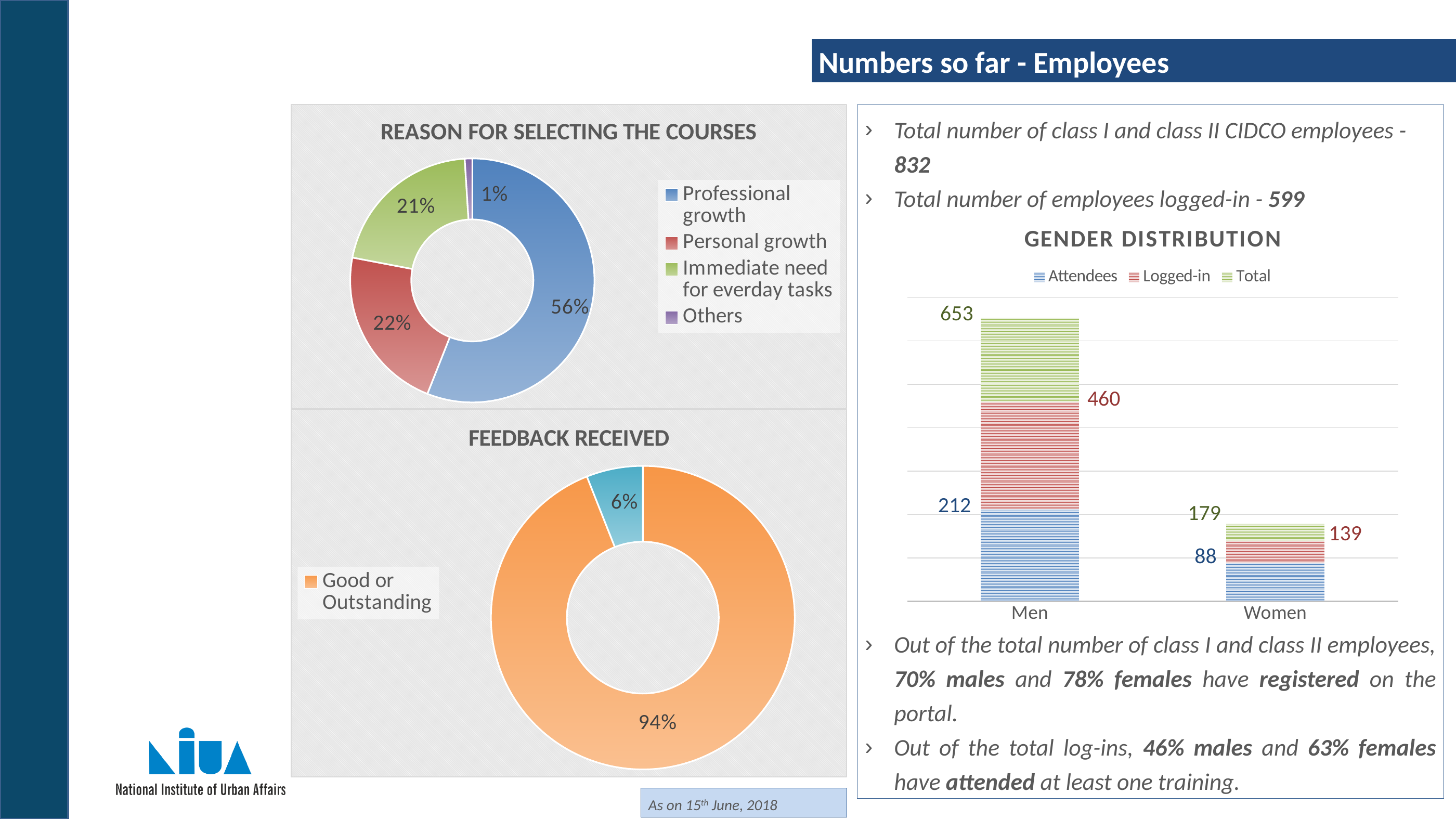
In the 'Feedback received' chart, what share is Good or Outstanding? 94% In the 'Gender distribution' chart, what is the Attendees value for Men? 212 In the 'Reason for selecting the courses' chart, which reason has the smallest share? Others In the 'Gender distribution' chart, how many series does the legend list? 3 In the 'Gender distribution' chart, what is the Logged-in value for Women? 139 What kind of chart is the 'Feedback received' chart? Doughnut chart In the 'Reason for selecting the courses' chart, what share is Professional growth? 56% In the 'Reason for selecting the courses' chart, what share is Immediate need for everday tasks? 21% In the 'Gender distribution' chart, what is the difference between the Total values for Men and Women? 474 In the 'Reason for selecting the courses' chart, what share is Personal growth? 22% In the 'Reason for selecting the courses' chart, how many categories does the legend list? 4 In the 'Gender distribution' chart, what is the Total value for Men? 653